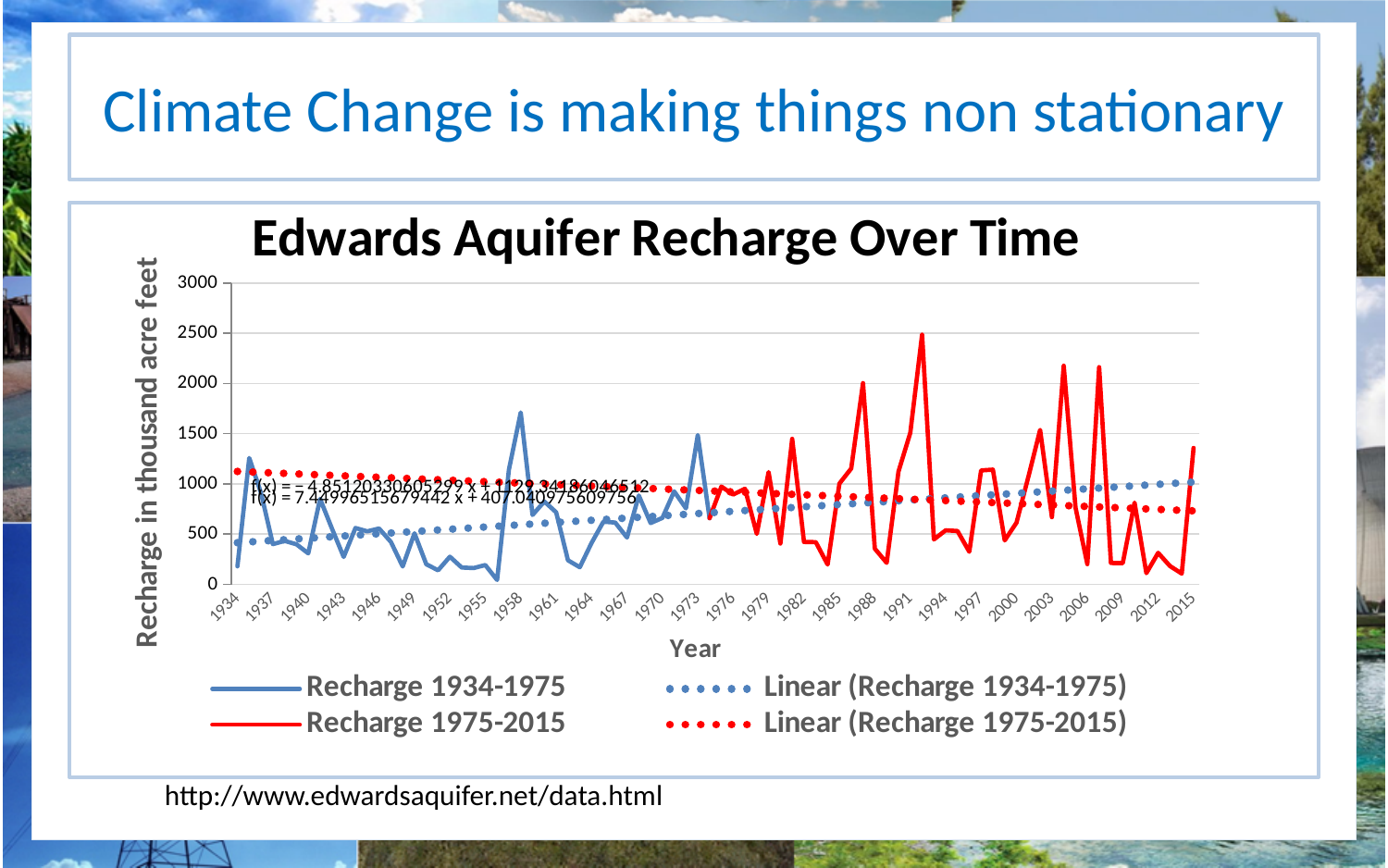
Is the highest value of the Recharge 1934-1975 series greater or less than 2000? less What is the label of the vertical axis? Recharge in thousand acre feet What is the title of the chart? Edwards Aquifer Recharge Over Time Does the Linear (Recharge 1934-1975) trendline rise or fall from left to right? rise Is the value for 1934 greater or less than 500? less Which series reaches a higher peak value, Recharge 1934-1975 or Recharge 1975-2015? Recharge 1975-2015 Is the highest value of the Recharge 1934-1975 series greater or less than 1500? greater How many entries does the chart legend list? 4 Does the Linear (Recharge 1975-2015) trendline rise or fall from left to right? fall What kind of chart is shown on the slide? line chart